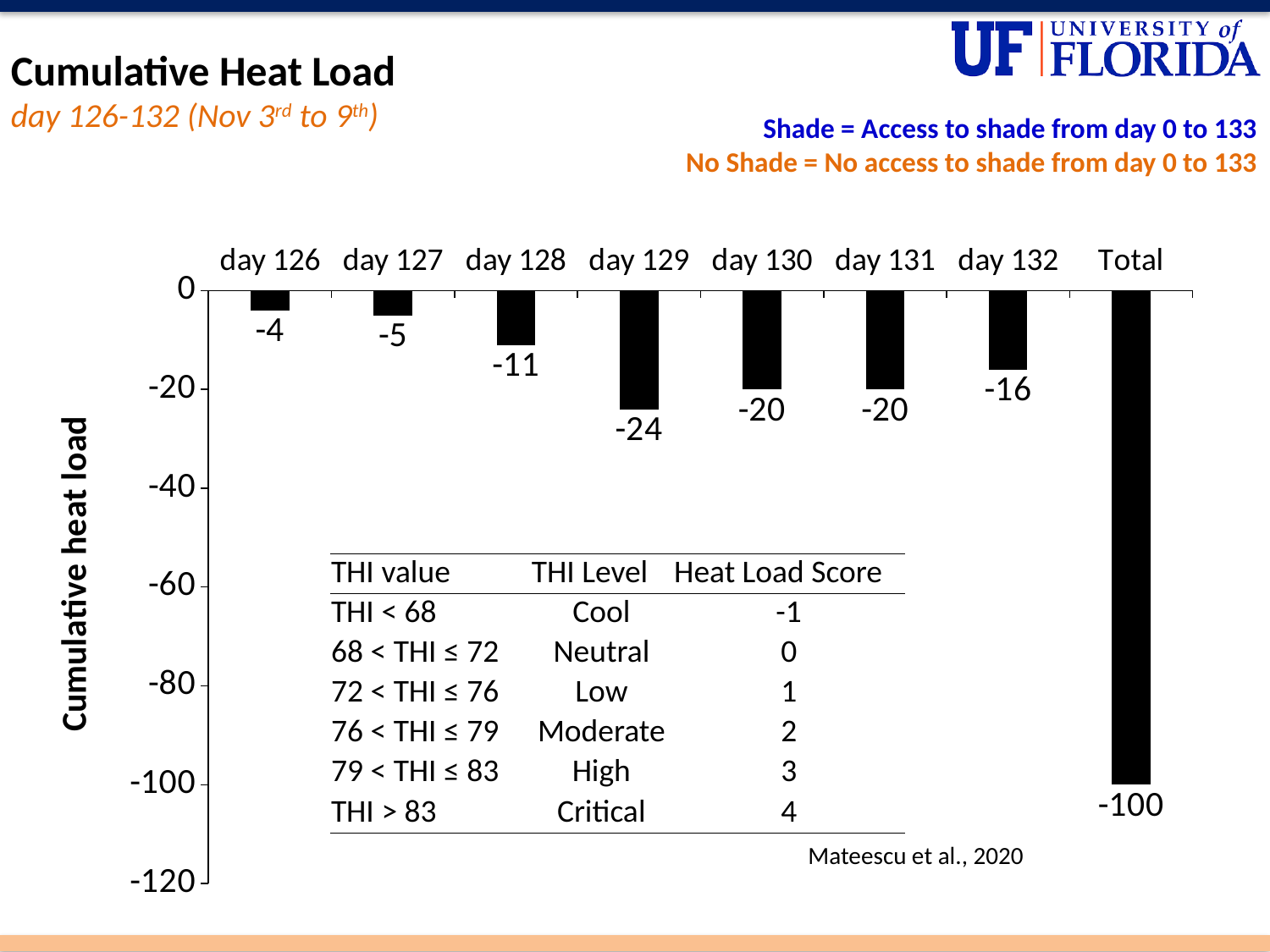
What is the value for day 126? -4 What is the difference between the values for day 129 and day 126? 20 Which day has the highest (least negative) cumulative heat load value? day 126 Is the value for day 129 greater or less than -20? less Which has the larger (less negative) value, day 127 or day 128? day 127 What is the label of the vertical axis? Cumulative heat load What is the cumulative heat load value for day 129? -24 Excluding the Total bar, which day has the lowest (most negative) cumulative heat load? day 129 What is the value shown for the Total bar? -100 How many bars are plotted in the chart, including the Total bar? 8 What is the cumulative heat load value for day 132? -16 What kind of chart is shown on the slide? bar chart